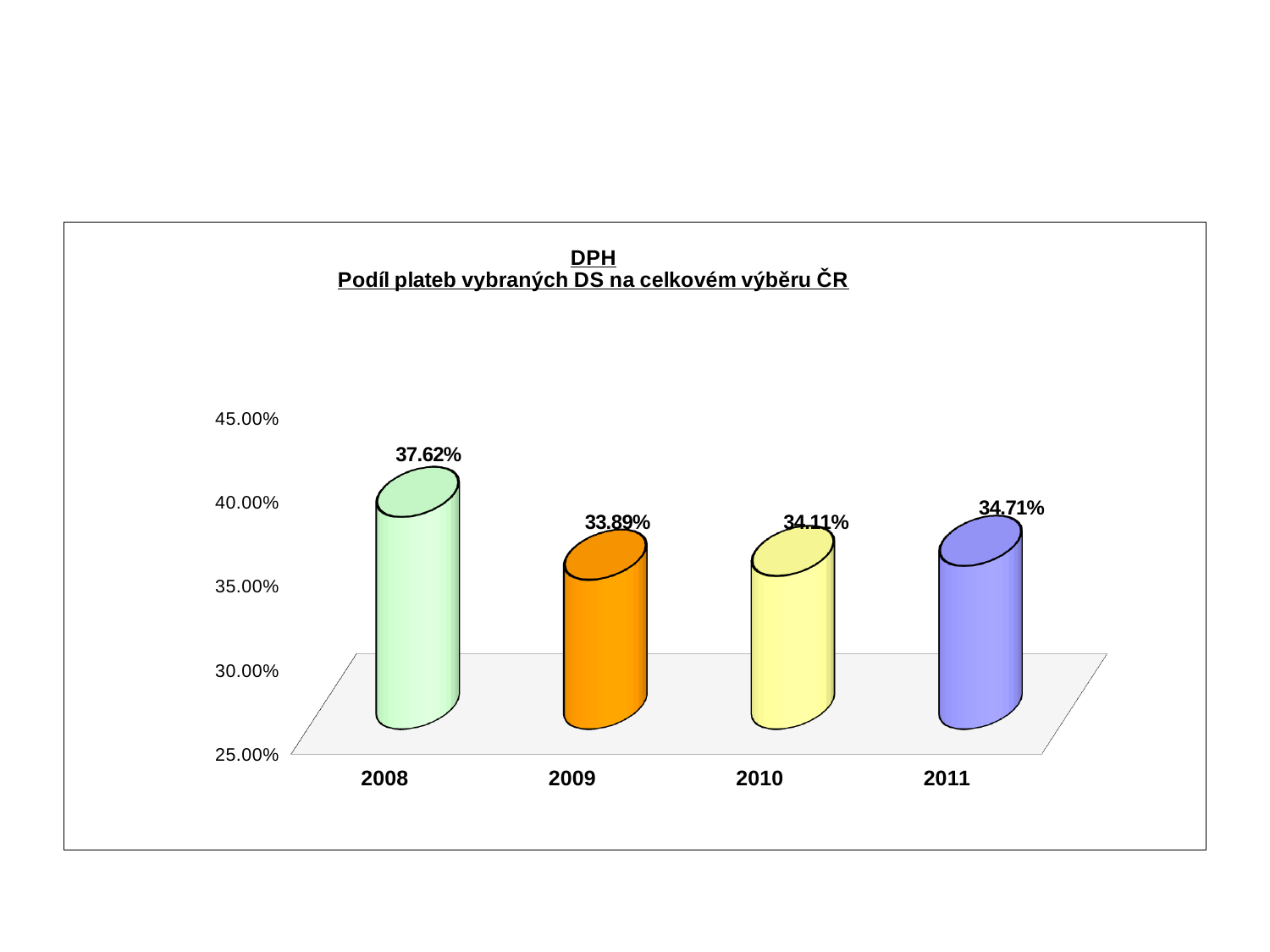
What is the difference between the values for 2008 and 2009? 3.73% What is the title of the chart? DPH Podíl plateb vybraných DS na celkovém výběru ČR Which is larger, the value for 2011 or the value for 2009? 2011 What is the value for 2008? 37.62% Which year has the lowest value? 2009 Which year has the highest value? 2008 How many years are shown on the chart? 4 What kind of chart is this? Bar chart What is the value for 2011? 34.71% What is the difference between the values for 2011 and 2010? 0.60% What is the value for 2010? 34.11% What is the value for 2009? 33.89%